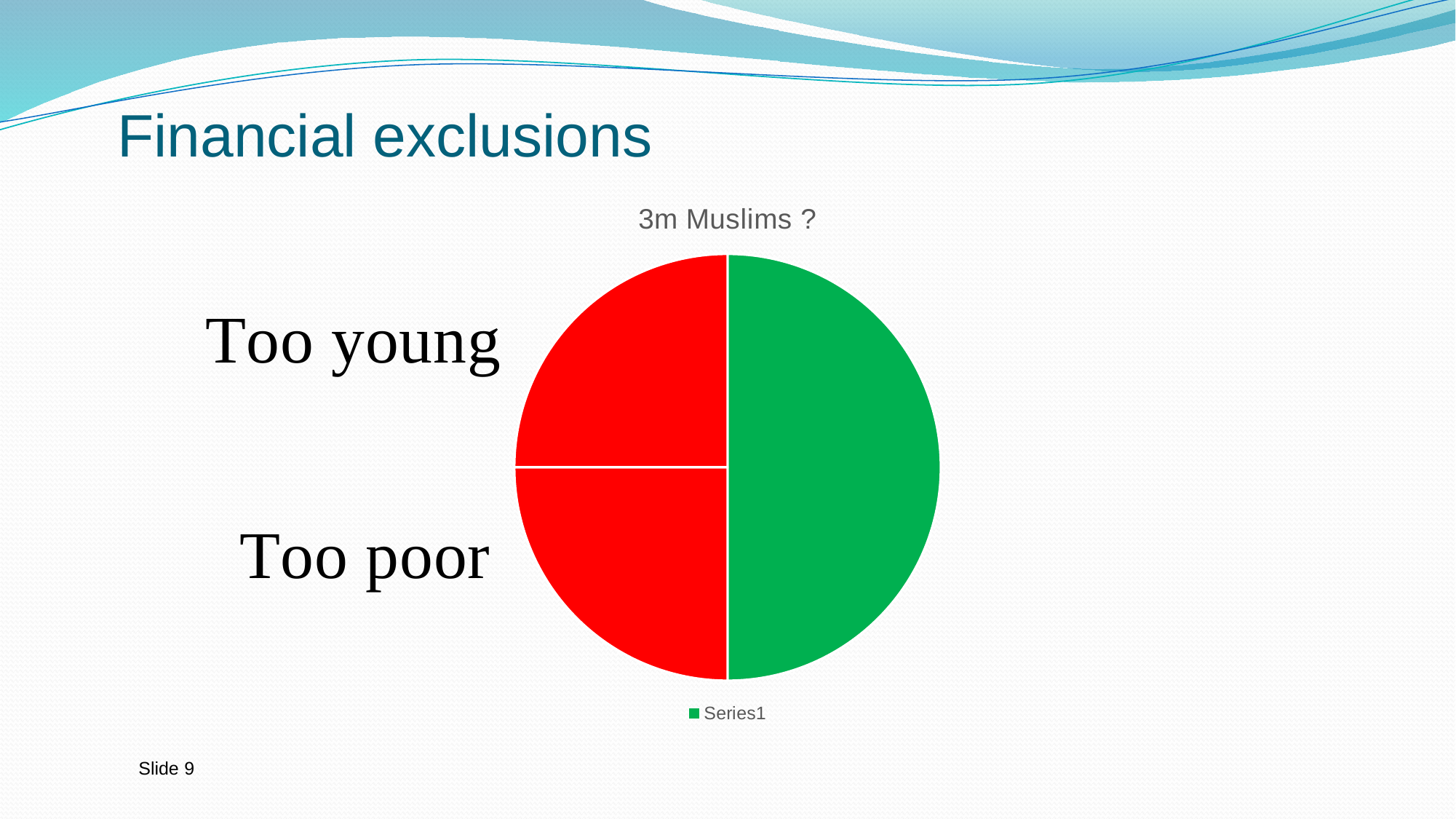
Which colour slice is the largest in the pie chart? green What kind of chart is shown on the slide? pie chart How many series does the legend of the pie chart list? 1 How many slices does the pie chart have? 3 Is the green slice of the pie chart larger or smaller than the upper red slice? larger What is the title of the pie chart? 3m Muslims ? How many red slices are there in the pie chart? 2 What is the name of the series shown in the legend of the pie chart? Series1